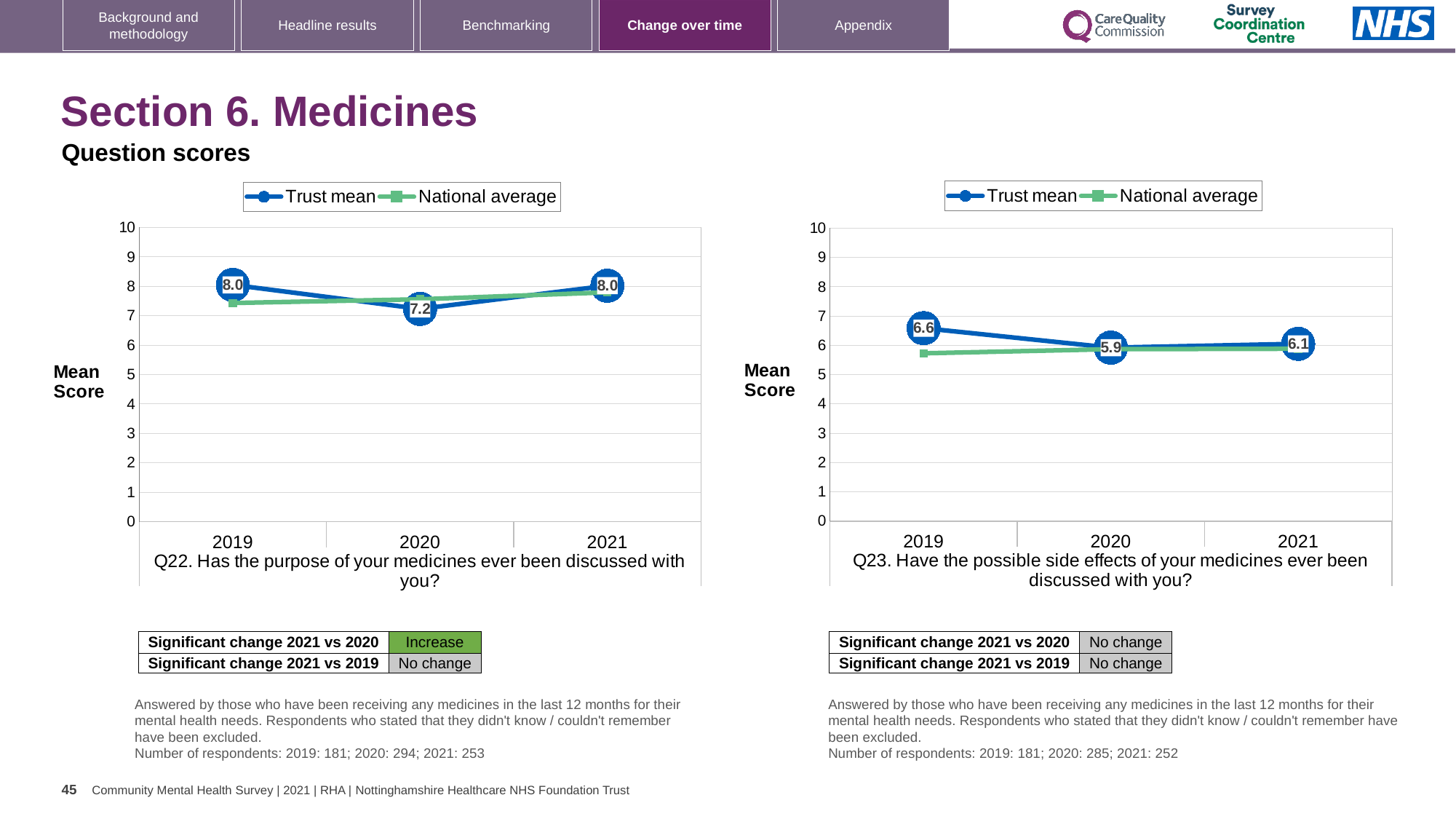
How many series does the legend of the Q22 chart on the left list? 2 In the Q23 chart on the right, is the Trust mean score higher in 2020 or in 2021? 2021 In the Q23 chart on the right, is the National average for 2019 greater or less than 6? less In the Q23 chart on the right, what is the Trust mean score for 2021? 6.1 In the Q22 chart on the left, what is the Trust mean score for 2020? 7.2 In the Q23 chart on the right, does the Trust mean rise or fall from 2019 to 2020? fall In the Q22 chart on the left, what is the difference between the Trust mean scores for 2021 and 2020? 0.8 In the Q23 chart on the right, what is the Trust mean score for 2019? 6.6 In the Q23 chart on the right, what is the difference between the Trust mean scores for 2019 and 2020? 0.7 In the Q23 chart on the right, which year has the highest Trust mean score? 2019 What kind of chart is the Q23 chart on the right? line chart In the Q22 chart on the left, which year has the lowest Trust mean score? 2020